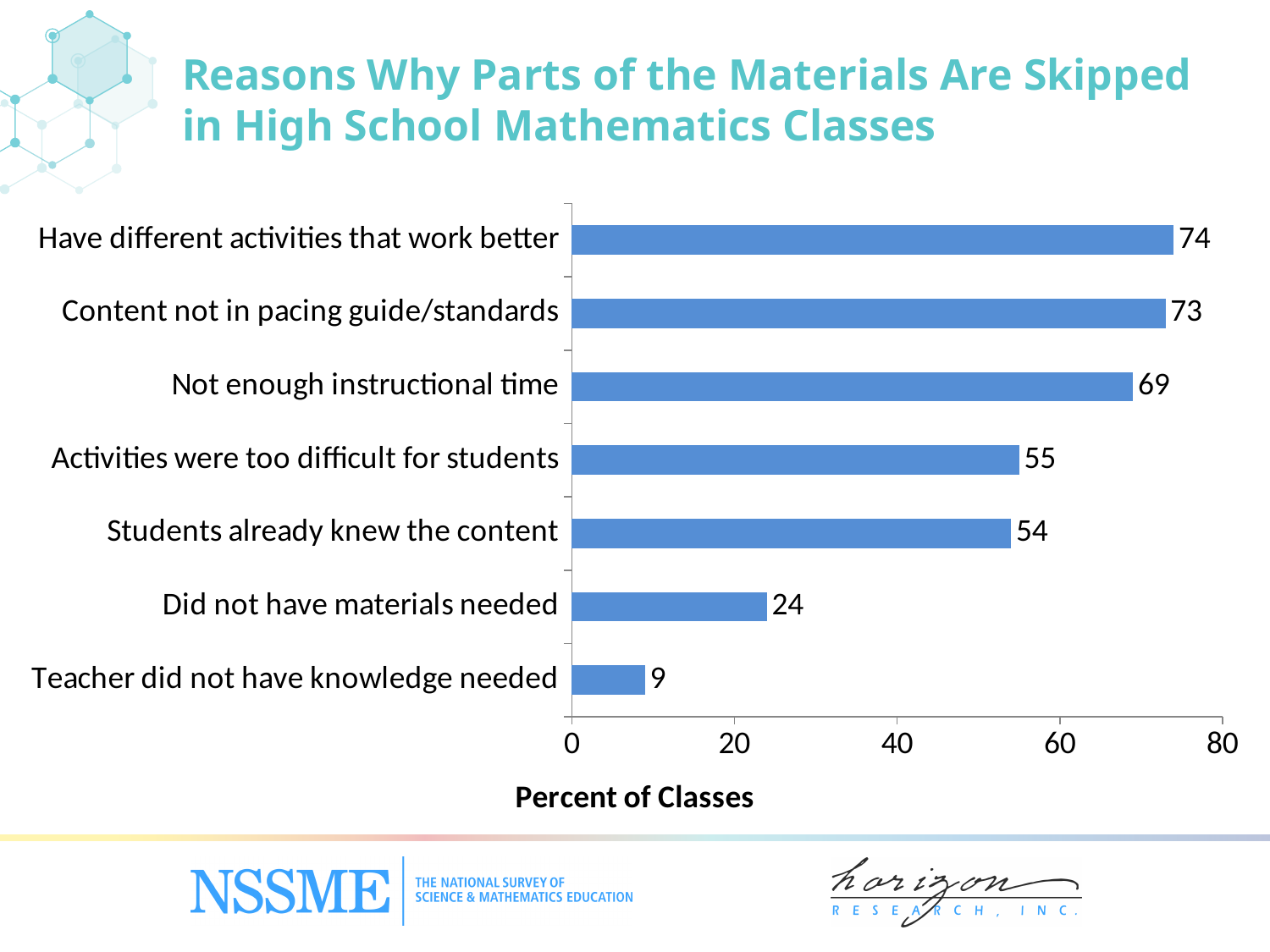
Which is larger: the value for 'Not enough instructional time' or the value for 'Activities were too difficult for students'? Not enough instructional time Which reason has the highest percent of classes? Have different activities that work better Which reason has the lowest percent of classes? Teacher did not have knowledge needed What is the value for 'Did not have materials needed'? 24 What is the difference between the values for 'Not enough instructional time' and 'Teacher did not have knowledge needed'? 60 What is the value for 'Not enough instructional time'? 69 How many reasons are shown in the chart? 7 What percent of classes skipped parts of the materials because they have different activities that work better? 74 What is the difference between the values for 'Content not in pacing guide/standards' and 'Did not have materials needed'? 49 What is the label of the horizontal axis? Percent of Classes Is the value for 'Students already knew the content' greater or less than 40? greater What kind of chart is shown on the slide? Bar chart